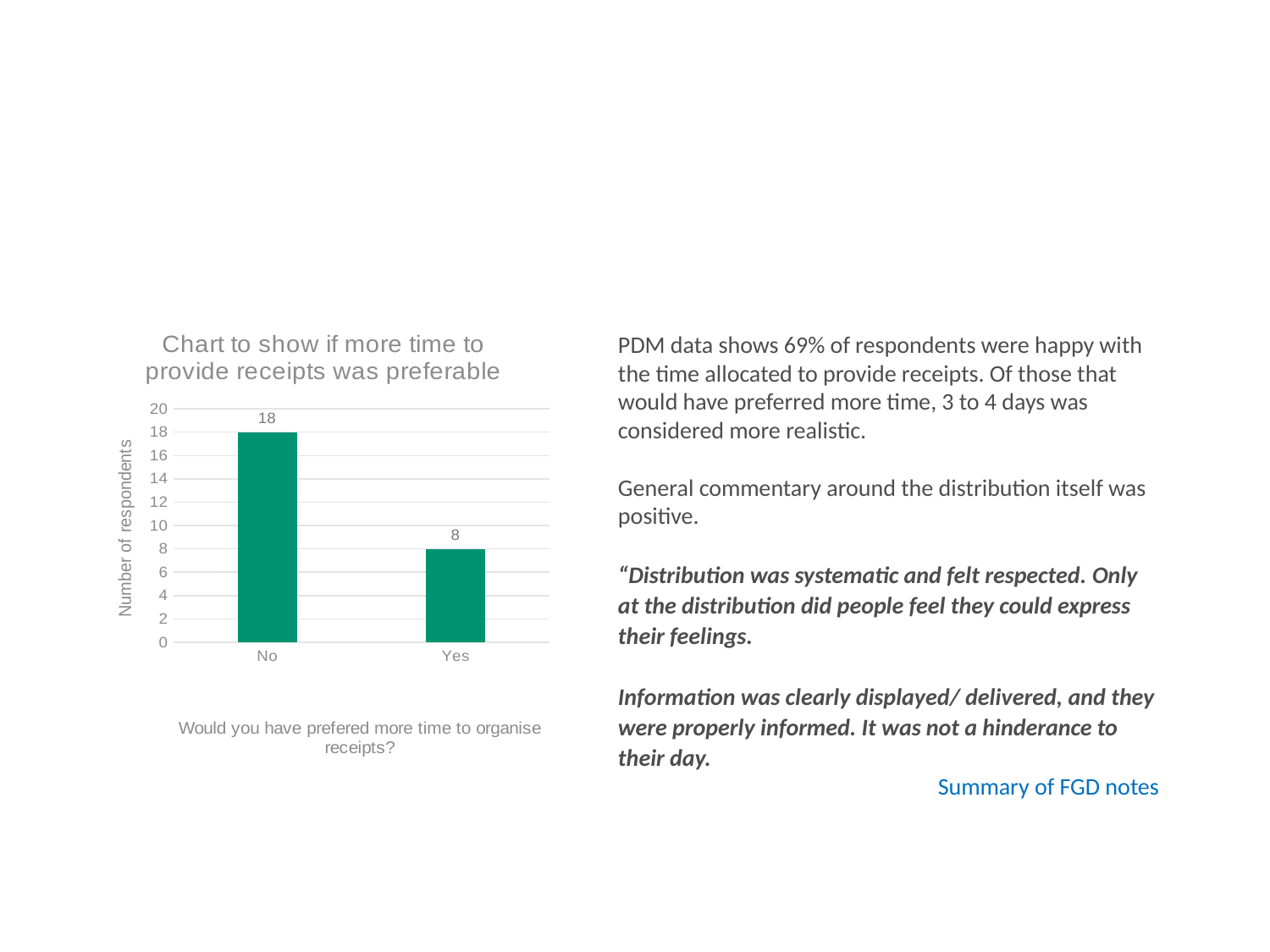
What is the label of the y axis? Number of respondents What is the number of respondents for "No"? 18 Which category has the lowest number of respondents? Yes How many categories are shown on the x axis? 2 What is the title of the chart? Chart to show if more time to provide receipts was preferable What kind of chart is shown on the slide? Bar chart Which is larger, the value for "No" or the value for "Yes"? No Which category has the highest number of respondents? No Is the value for "Yes" greater or less than 10? less What is the difference between the number of respondents for "No" and "Yes"? 10 What is the total number of respondents across both categories? 26 What is the number of respondents for "Yes"? 8